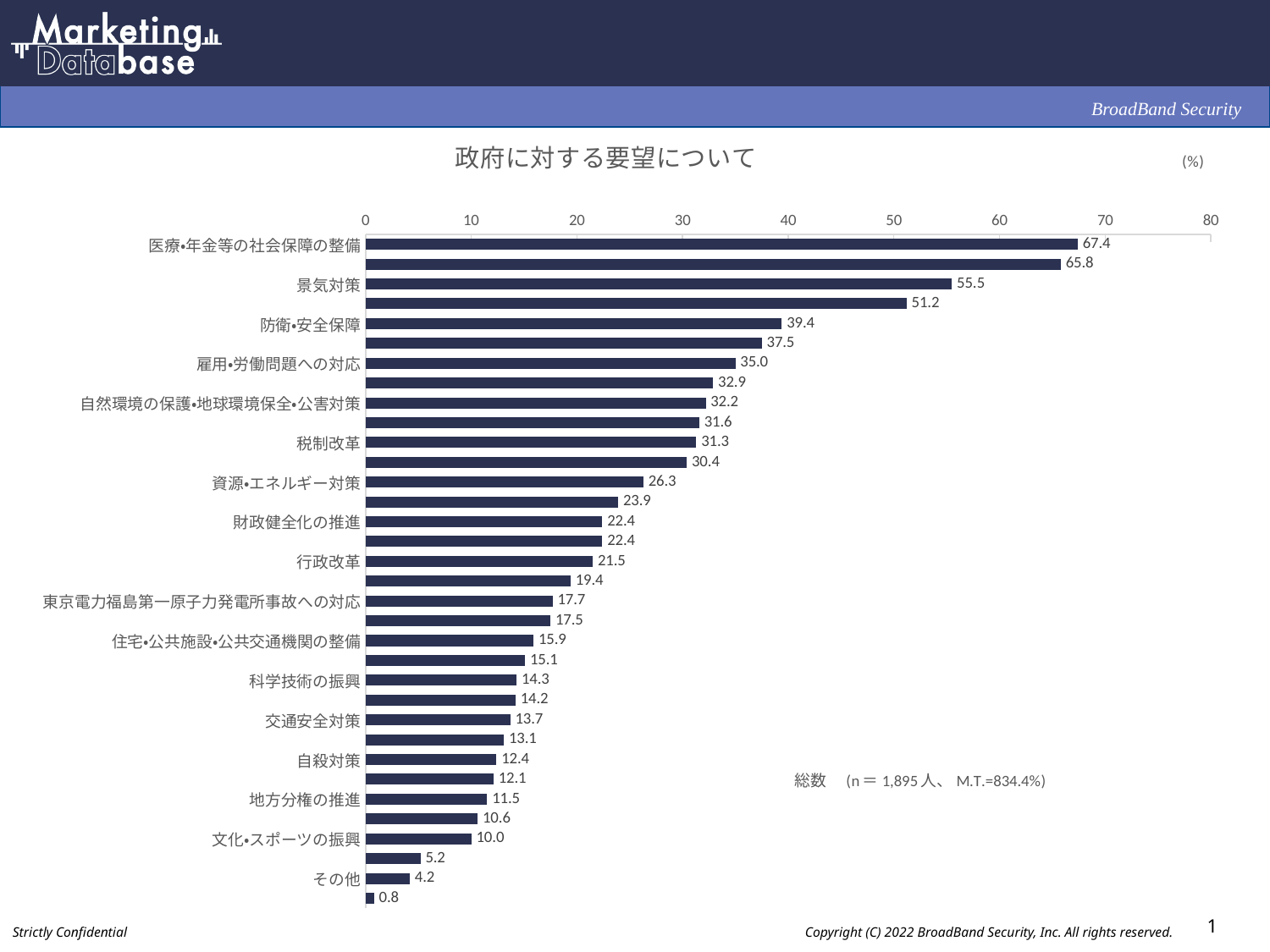
What is the value for 東京電力福島第一原子力発電所事故への対応? 17.7 What sample size (n) is stated on the slide? 1,895 What is the value for 医療•年金等の社会保障の整備? 67.4 What is the value for その他? 4.2 Which is larger, the value for 税制改革 or the value for 資源•エネルギー対策? 税制改革 Which category has the highest value? 医療•年金等の社会保障の整備 What is the smallest value labeled on the chart? 0.8 What type of chart is shown on the slide? bar chart What is the value for 防衛•安全保障? 39.4 What is the difference between the values for 医療•年金等の社会保障の整備 and 景気対策? 11.9 What is the title of the chart? 政府に対する要望について What is the value for 景気対策? 55.5